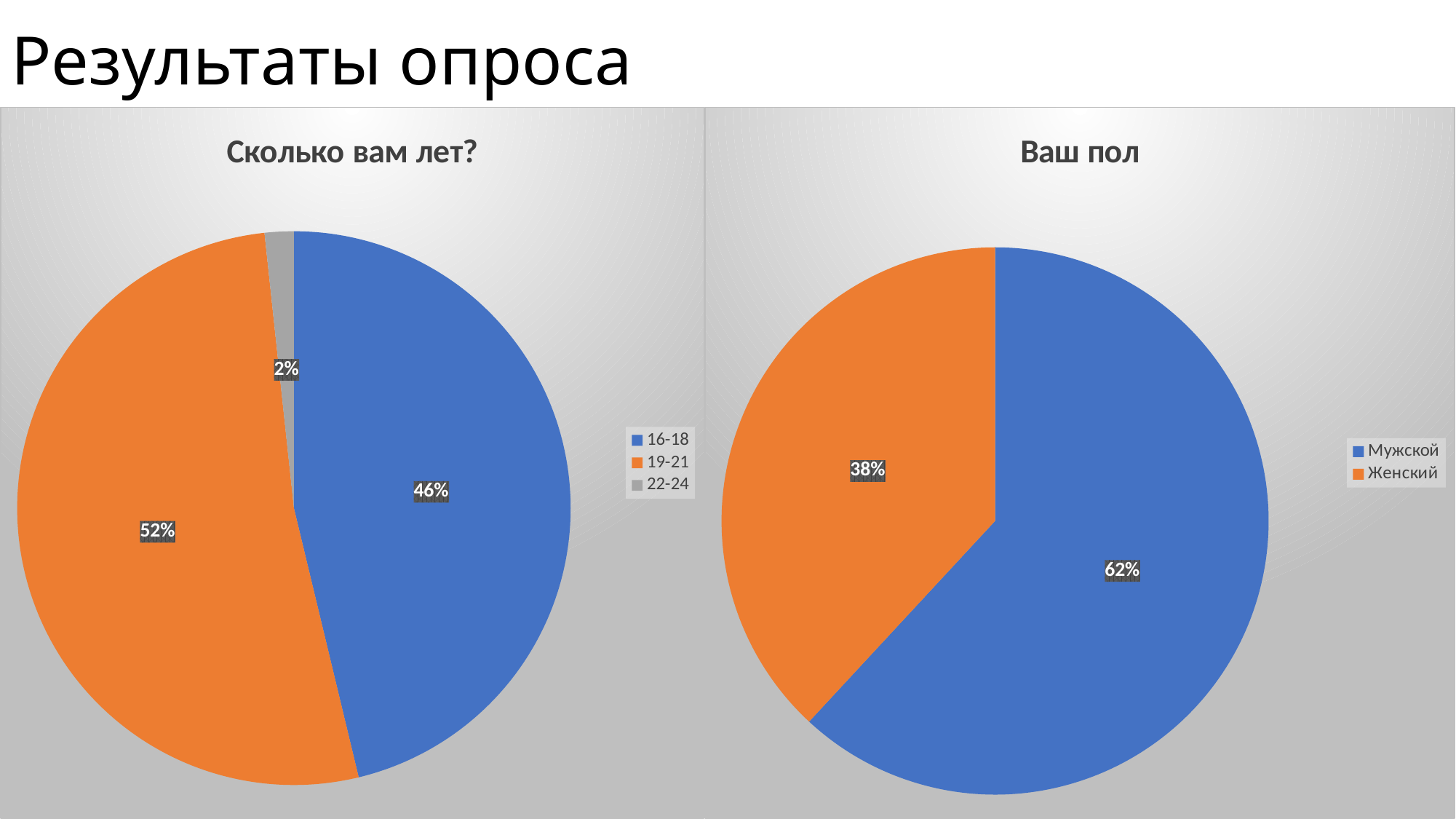
In the chart titled "Сколько вам лет?", how many age groups are shown? 3 In the chart titled "Сколько вам лет?", which age group has the smallest share? 22-24 In the chart titled "Сколько вам лет?", what is the difference in percentage points between the 19-21 and 16-18 groups? 6 In the chart titled "Сколько вам лет?", what share of respondents are aged 22-24? 2% In the chart titled "Сколько вам лет?", what share of respondents are aged 19-21? 52% In the chart titled "Ваш пол", what is the difference in percentage points between Мужской and Женский? 24 In the chart titled "Ваш пол", what share of respondents are Мужской? 62% What kind of chart is the chart titled "Ваш пол"? Pie chart In the chart titled "Ваш пол", which category is larger, Мужской or Женский? Мужской In the chart titled "Ваш пол", what share of respondents are Женский? 38% In the chart titled "Сколько вам лет?", what share of respondents are aged 16-18? 46% In the chart titled "Сколько вам лет?", which age group has the largest share? 19-21